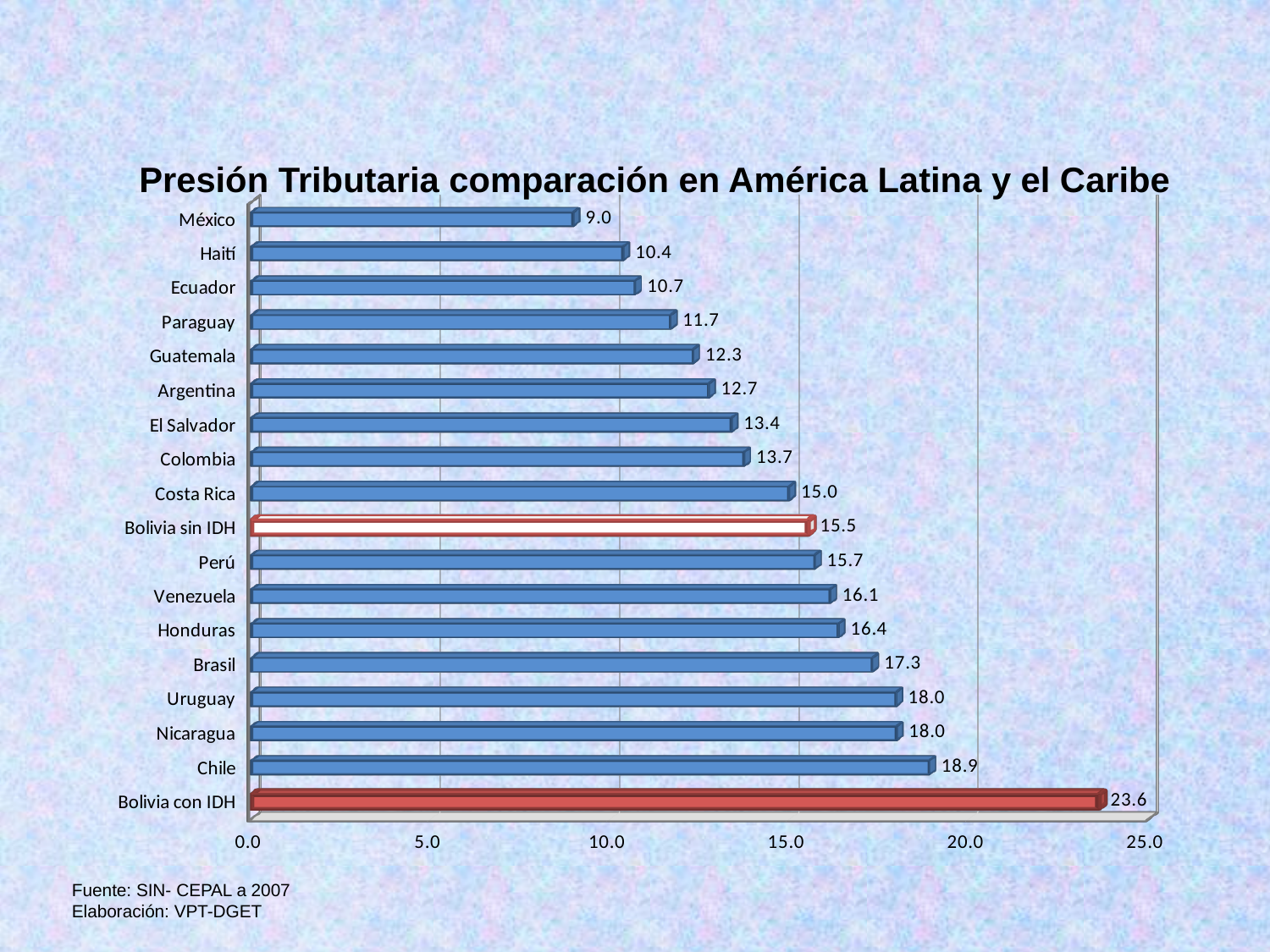
What is the difference between the values for Brasil and Haití? 6.9 What is the value for Bolivia sin IDH? 15.5 How many categories are shown in the chart? 18 Which is larger, the value for Costa Rica or the value for Colombia? Costa Rica What is the value for Guatemala? 12.3 Which category has the lowest value? México What is the title of the chart? Presión Tributaria comparación en América Latina y el Caribe Is the value for Venezuela greater or less than 15.0? greater What kind of chart is shown on the slide? bar chart What is the difference between the values for Bolivia con IDH and Chile? 4.7 What is the value for Chile? 18.9 Which category has the highest value? Bolivia con IDH